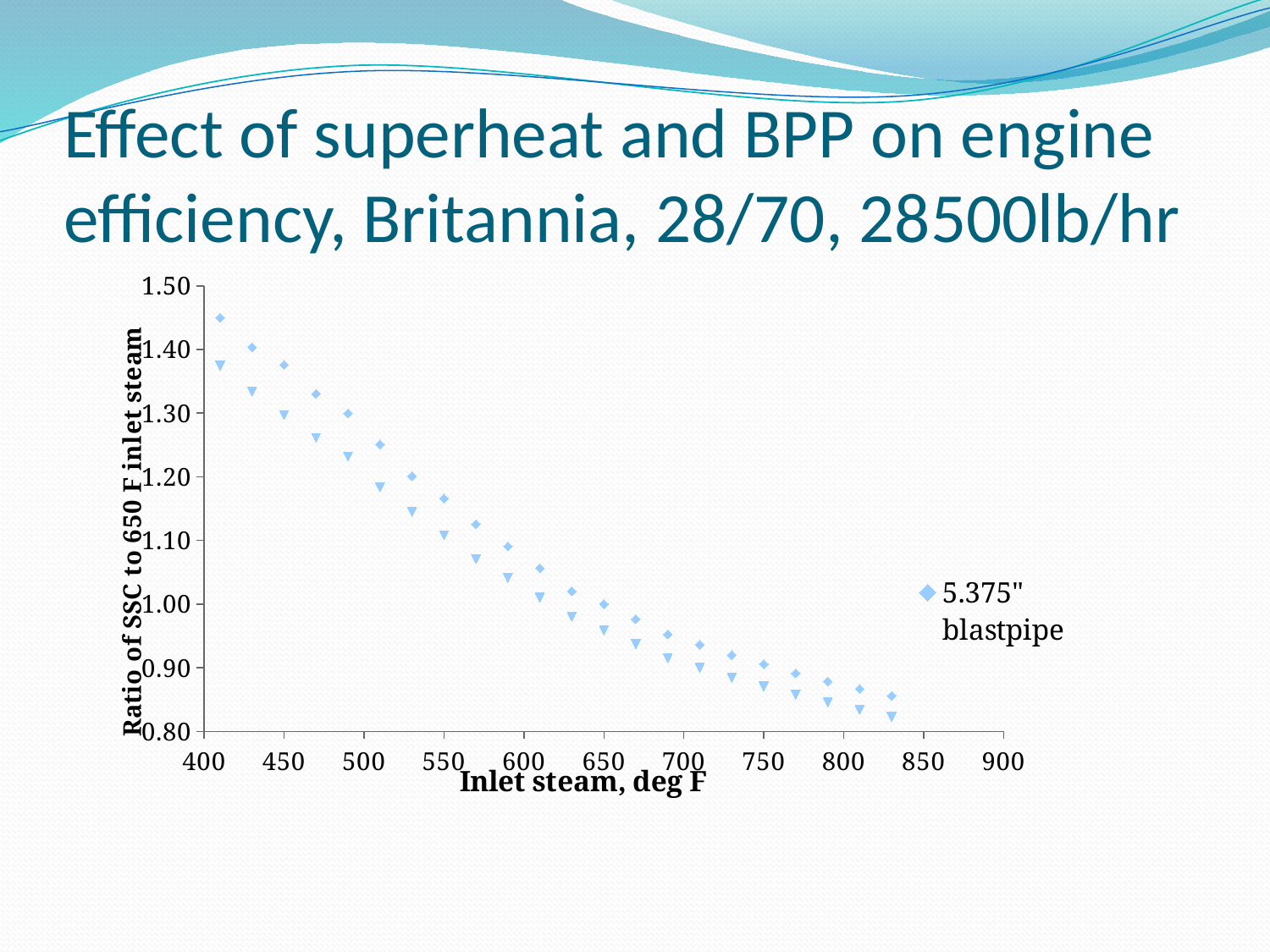
Is the value for the 5.375" blastpipe series at 510 deg F greater or less than 1.20? greater At which inlet steam temperature does the 5.375" blastpipe series reach its highest value? 410 At 410 deg F, which marker is higher on the chart, the diamond or the triangle? diamond What is the legend entry shown on the chart? 5.375" blastpipe What is the title of the x axis of the chart? Inlet steam, deg F Is the value for the 5.375" blastpipe series at 830 deg F greater or less than 0.90? less Is the value for the 5.375" blastpipe series at 410 deg F greater or less than 1.40? greater At which inlet steam temperature does the 5.375" blastpipe series reach its lowest value? 830 How many series does the chart legend list? 1 Do the values of the 5.375" blastpipe series rise or fall as inlet steam temperature increases? fall What kind of chart is shown on the slide? scatter chart